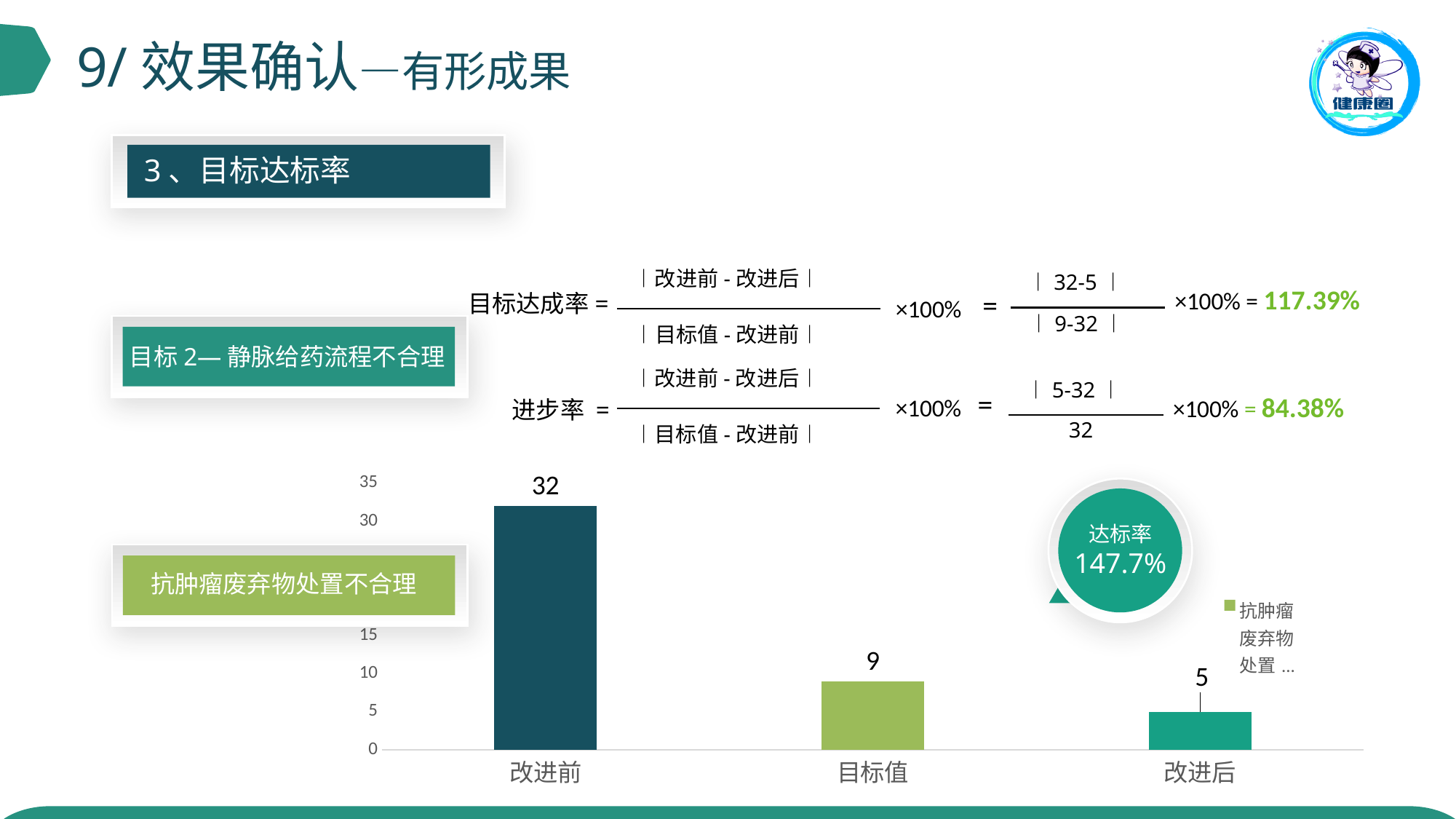
How many categories are shown on the x axis? 3 Is the value for 改进前 greater or less than 30? greater Which category has the lowest value? 改进后 What is the difference between the values for 改进前 and 改进后? 27 Which is larger, the value for 目标值 or the value for 改进后? 目标值 Do the values rise or fall from 改进前 to 改进后 along the x axis? fall What is the value for 改进前? 32 Which category has the highest value? 改进前 What kind of chart is shown on the slide? bar chart What is the difference between the values for 目标值 and 改进后? 4 What is the value for 改进后? 5 What is the value for 目标值? 9